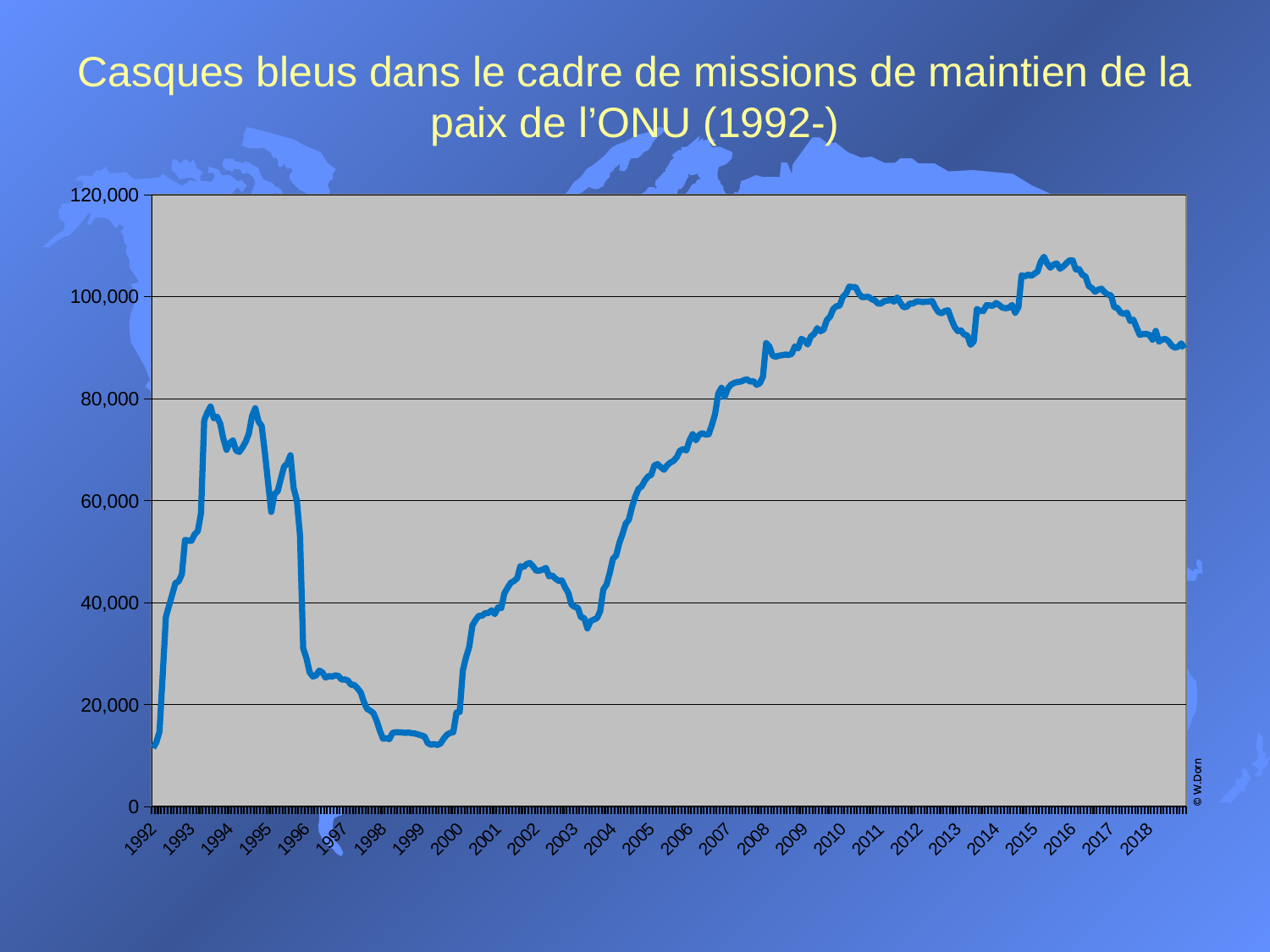
Is the value at the start of 1993 greater or less than 40,000? greater What is the title of the chart? Casques bleus dans le cadre de missions de maintien de la paix de l'ONU (1992-) What is the highest value shown on the y axis? 120,000 What kind of chart is shown on the slide? line chart Is the value at the start of 2018 greater or less than 80,000? greater How many year labels are shown on the x axis? 27 Does the line generally rise or fall between 2016 and 2018? fall Which is larger, the value at the start of 2015 or the value at the start of 1994? 2015 Does the line generally rise or fall between 2000 and 2010? rise Is the value at the start of 1998 greater or less than 20,000? less